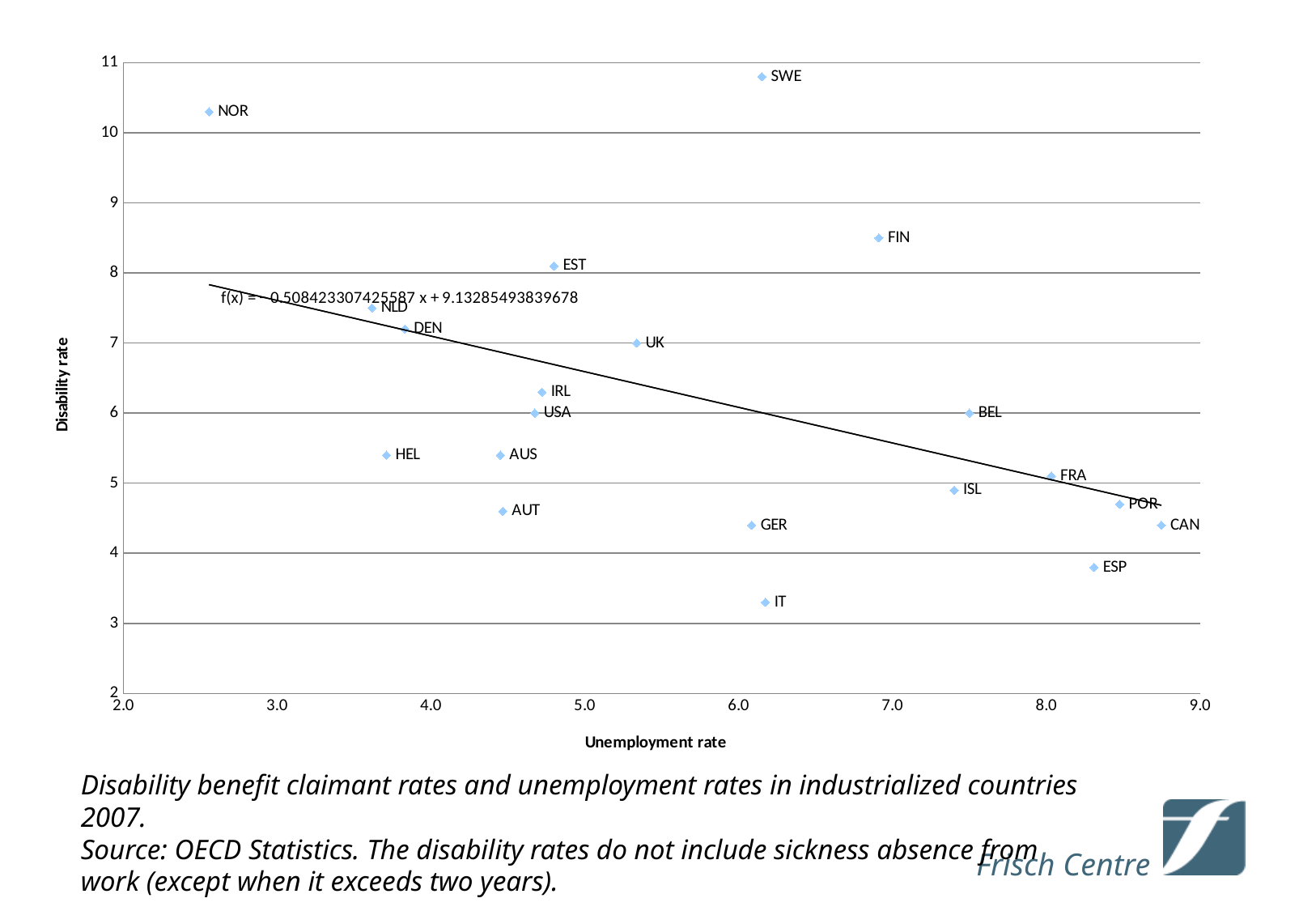
What is the label of the x axis? Unemployment rate Is the disability rate for NOR greater or less than 10? greater Is the unemployment rate for FIN greater or less than 6.0? greater How many countries are plotted on the chart? 20 Which has the higher disability rate, FIN or EST? FIN What kind of chart is shown on the slide? scatter chart Is the disability rate for ESP greater or less than 4? less Which country has the highest unemployment rate on the chart? CAN Which country has the highest disability rate on the chart? SWE Which country has the lowest disability rate on the chart? IT According to the fitted line, does the disability rate rise or fall as the unemployment rate increases? fall Which country has the lowest unemployment rate on the chart? NOR